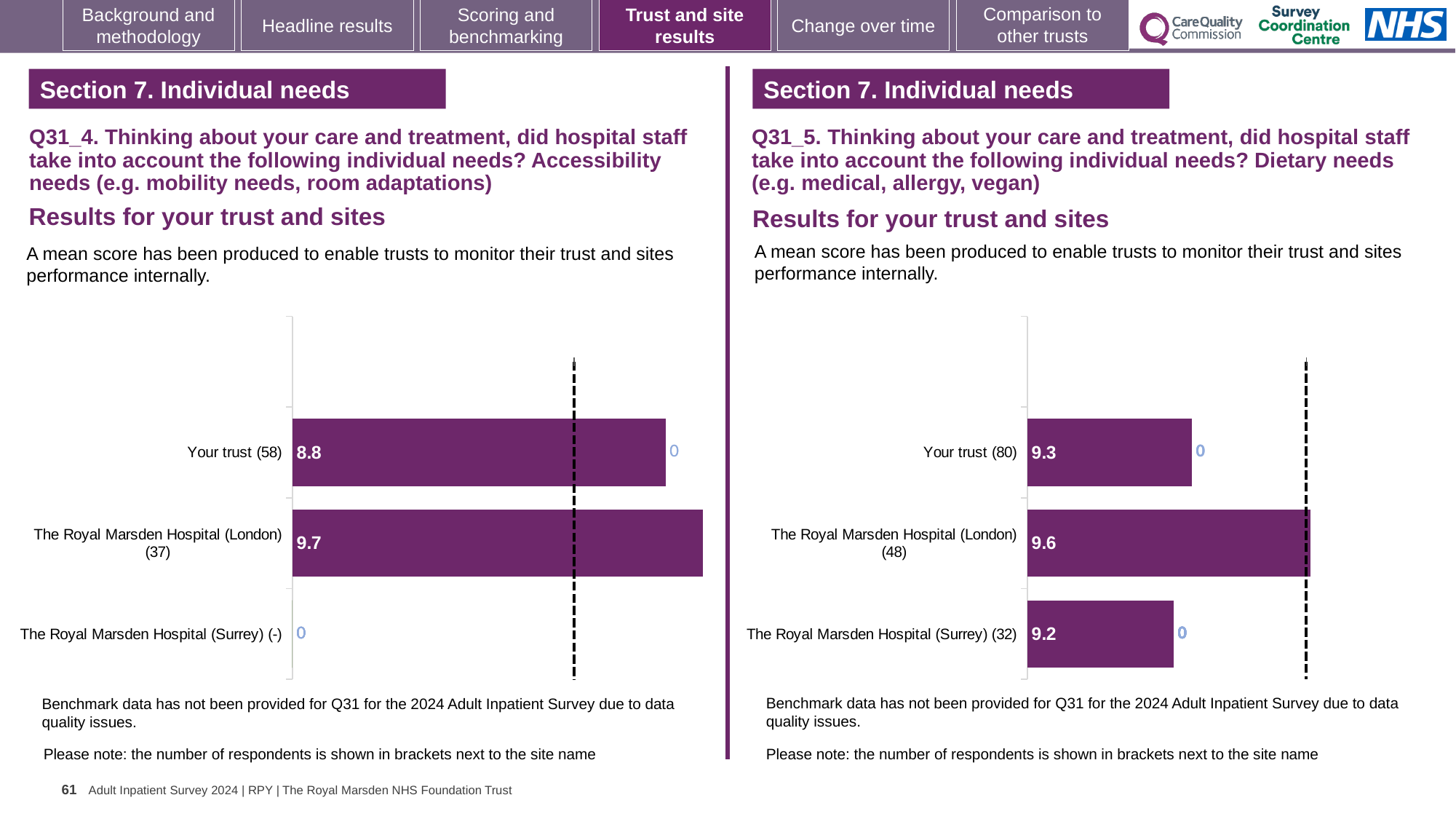
On the Q31_5 (Dietary needs) chart, how many respondents are shown for Your trust? 80 On the Q31_5 (Dietary needs) chart, what is the mean score for The Royal Marsden Hospital (Surrey)? 9.2 On the Q31_5 (Dietary needs) chart, which site has the highest mean score? The Royal Marsden Hospital (London) On the Q31_4 (Accessibility needs) chart, what is the difference between the mean scores for The Royal Marsden Hospital (London) and Your trust? 0.9 On the Q31_5 (Dietary needs) chart, what is the mean score for Your trust? 9.3 On the Q31_5 (Dietary needs) chart, which site has the lowest mean score? The Royal Marsden Hospital (Surrey) On the Q31_4 (Accessibility needs) chart, how many respondents are shown for The Royal Marsden Hospital (London)? 37 On the Q31_4 (Accessibility needs) chart, what is the mean score for The Royal Marsden Hospital (London)? 9.7 On the Q31_4 (Accessibility needs) chart, which has the higher mean score: Your trust or The Royal Marsden Hospital (London)? The Royal Marsden Hospital (London) On the Q31_5 (Dietary needs) chart, what is the difference between the mean scores for The Royal Marsden Hospital (London) and The Royal Marsden Hospital (Surrey)? 0.4 What type of chart is used on the Q31_5 (Dietary needs) side of the slide? Bar chart On the Q31_4 (Accessibility needs) chart, what is the mean score for Your trust? 8.8